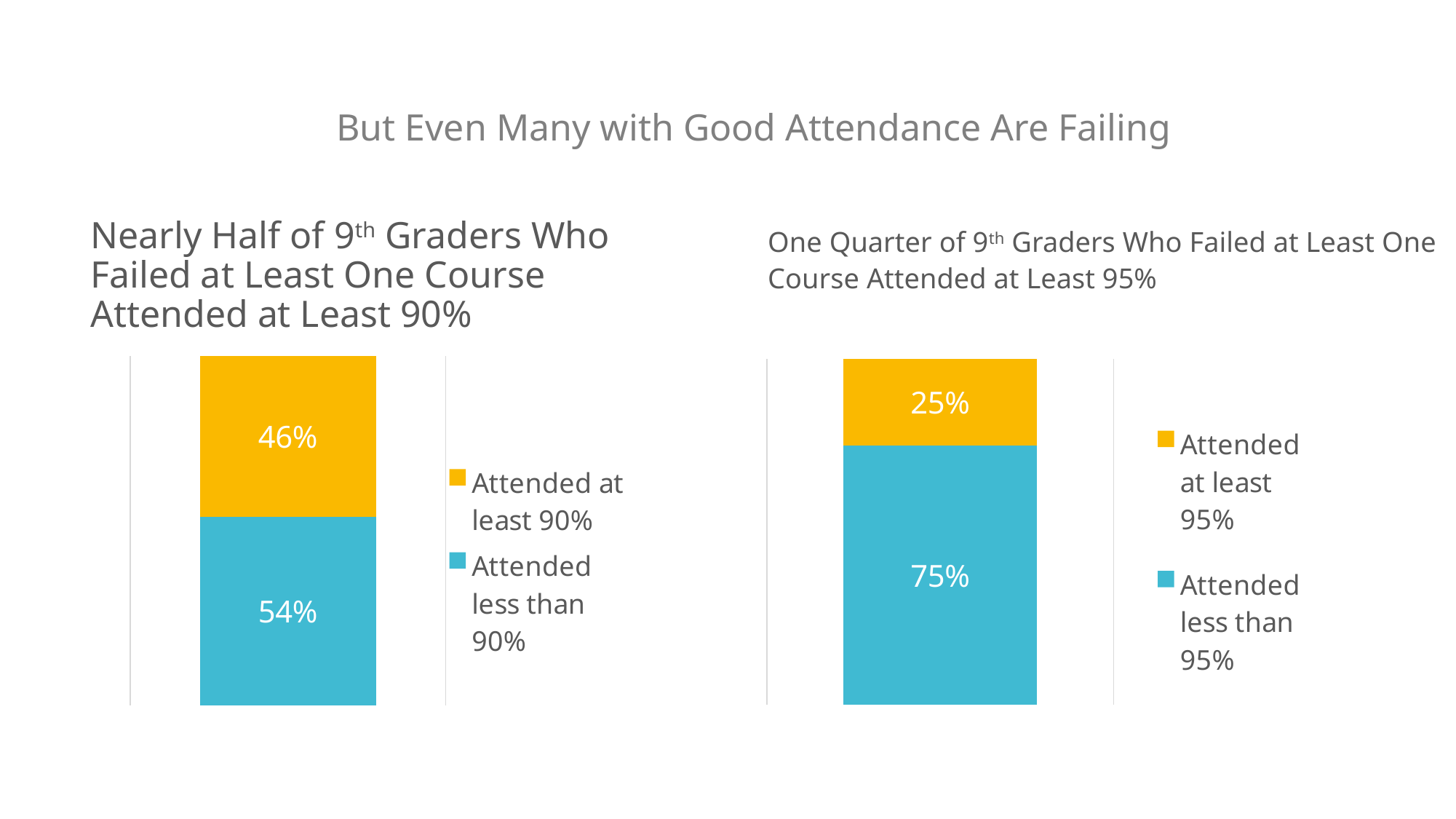
How many series does the legend of the right chart list? 2 What type of chart is shown on the left side of the slide? Stacked bar chart In the left chart, what percentage attended less than 90%? 54% In the right chart, which colour represents students who attended at least 95%? Yellow In the left chart, which segment is larger: attended at least 90% or attended less than 90%? Attended less than 90% In the left chart, what is the difference between the share that attended less than 90% and the share that attended at least 90%? 8% In the left chart, what percentage of 9th graders who failed at least one course attended at least 90%? 46% In the right chart, what percentage attended less than 95%? 75% In the right chart, which segment is smaller: attended at least 95% or attended less than 95%? Attended at least 95% In the right chart, what percentage of 9th graders who failed at least one course attended at least 95%? 25% In the right chart, what is the difference between the share that attended less than 95% and the share that attended at least 95%? 50% What is the total of the stacked bar in the left chart? 100%